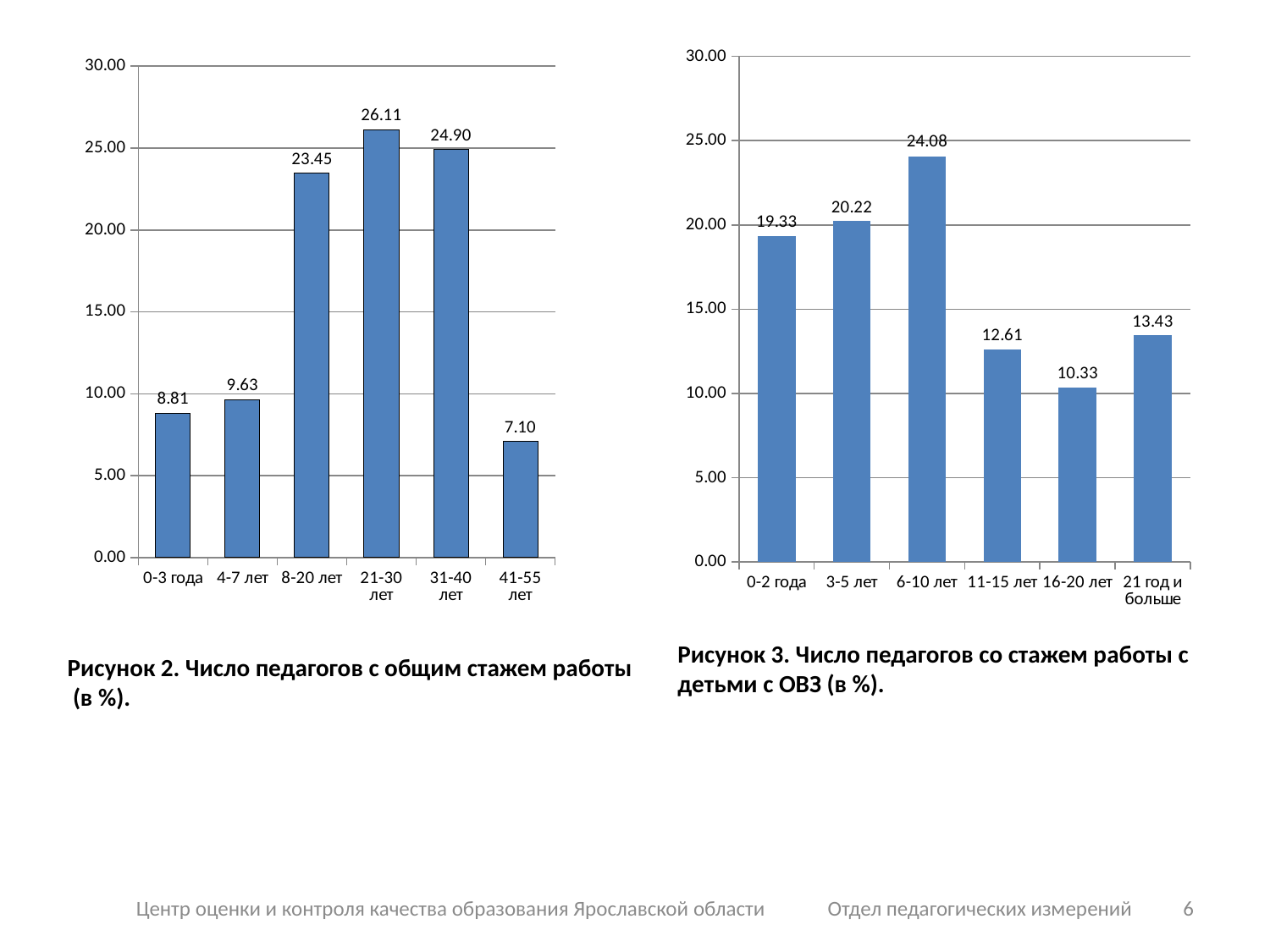
In the right chart (Рисунок 3), what is the value for the 6-10 лет category? 24.08 In the left chart (Рисунок 2), what is the value for the 21-30 лет category? 26.11 In the left chart (Рисунок 2), which category has the lowest value? 41-55 лет What type of chart is the right chart (Рисунок 3)? Bar chart In the right chart (Рисунок 3), which is larger: the value for 11-15 лет or the value for 21 год и больше? 21 год и больше In the left chart (Рисунок 2), how many categories are shown on the x axis? 6 In the left chart (Рисунок 2), what is the value for the 0-3 года category? 8.81 In the right chart (Рисунок 3), which category has the highest value? 6-10 лет In the left chart (Рисунок 2), what is the difference between the values for 8-20 лет and 4-7 лет? 13.82 In the right chart (Рисунок 3), what is the value for the 16-20 лет category? 10.33 In the right chart (Рисунок 3), what is the difference between the values for 3-5 лет and 0-2 года? 0.89 In the left chart (Рисунок 2), which category has the highest value? 21-30 лет